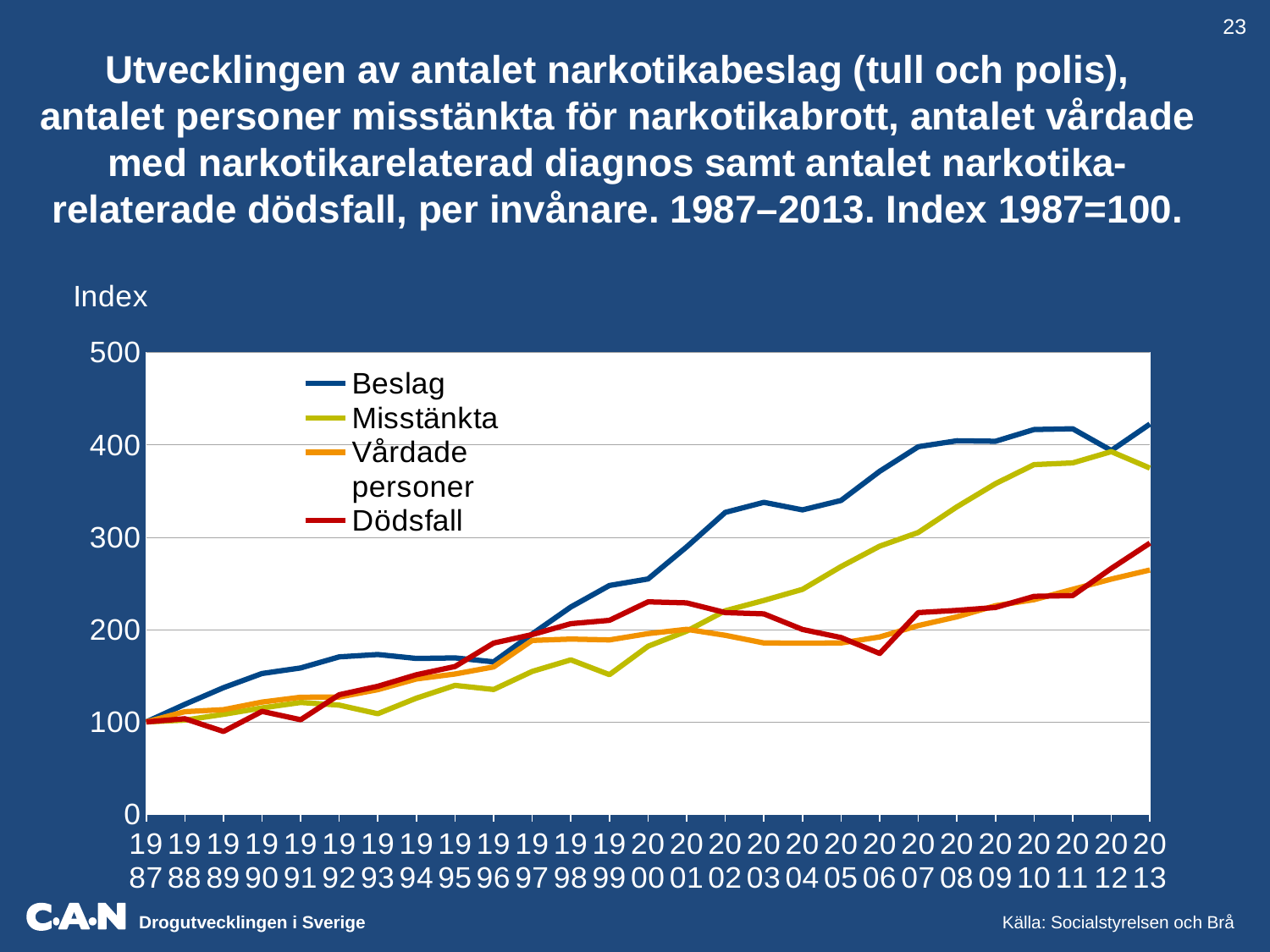
Which series has the lowest value in 2013? Vårdade personer Which series has the highest value in 2013? Beslag Which is larger in 1999, the value for Beslag or the value for Misstänkta? Beslag Is the value for Beslag in 2013 greater or less than 400? greater What kind of chart is shown on the slide? Line chart Does the Beslag series generally rise or fall from 1987 to 2013? Rise What colour is the Dödsfall line? Red How many years are shown along the x axis? 27 How many series does the legend list? 4 Is the value for Misstänkta in 2010 greater or less than 400? less Is the value for Dödsfall in 2006 greater or less than 200? less What is the index value of all series in 1987? 100